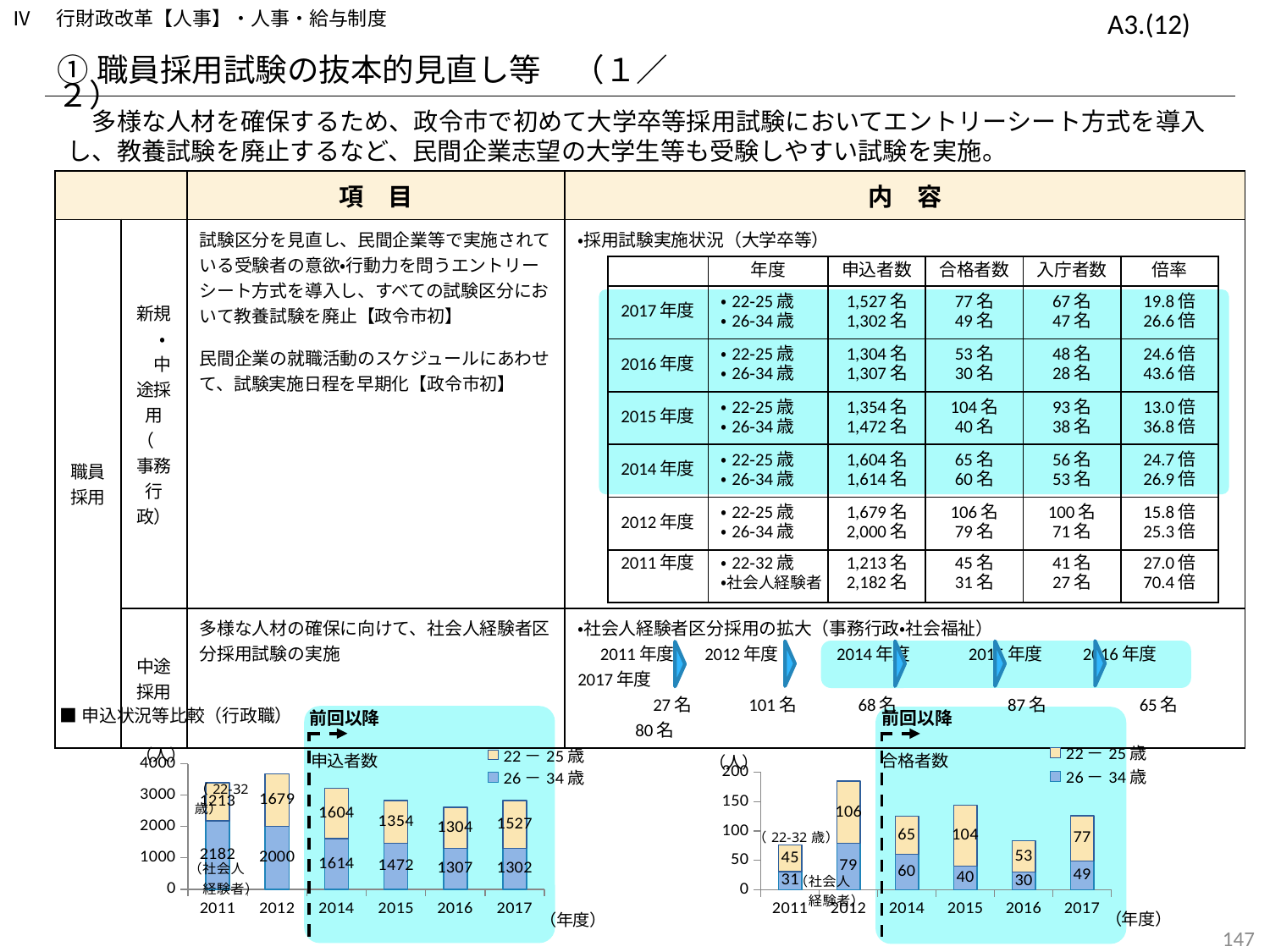
In the 申込者数 chart, what is the total of the stacked bar for 2014? 3218 In the 申込者数 chart, what is the value for 22－25歳 in 2017? 1527 In the 申込者数 chart, does the 26－34歳 value rise or fall from 2014 to 2017? fall How many years are shown on the x axis of the 申込者数 chart? 6 In the 合格者数 chart, what is the value for 26－34歳 in 2015? 40 In the 申込者数 chart, what is the value for 26－34歳 in 2014? 1614 In the 合格者数 chart, what is the total of the stacked bar for 2015? 144 In the 合格者数 chart, which is larger in 2015: 22－25歳 or 26－34歳? 22－25歳 In the 合格者数 chart, which year has the highest value for 22－25歳? 2012 In the 合格者数 chart, which year has the lowest value for 26－34歳? 2016 In the 申込者数 chart, what is the difference between the 22－25歳 and 26－34歳 values in 2017? 225 How many series does the legend of the 合格者数 chart list? 2